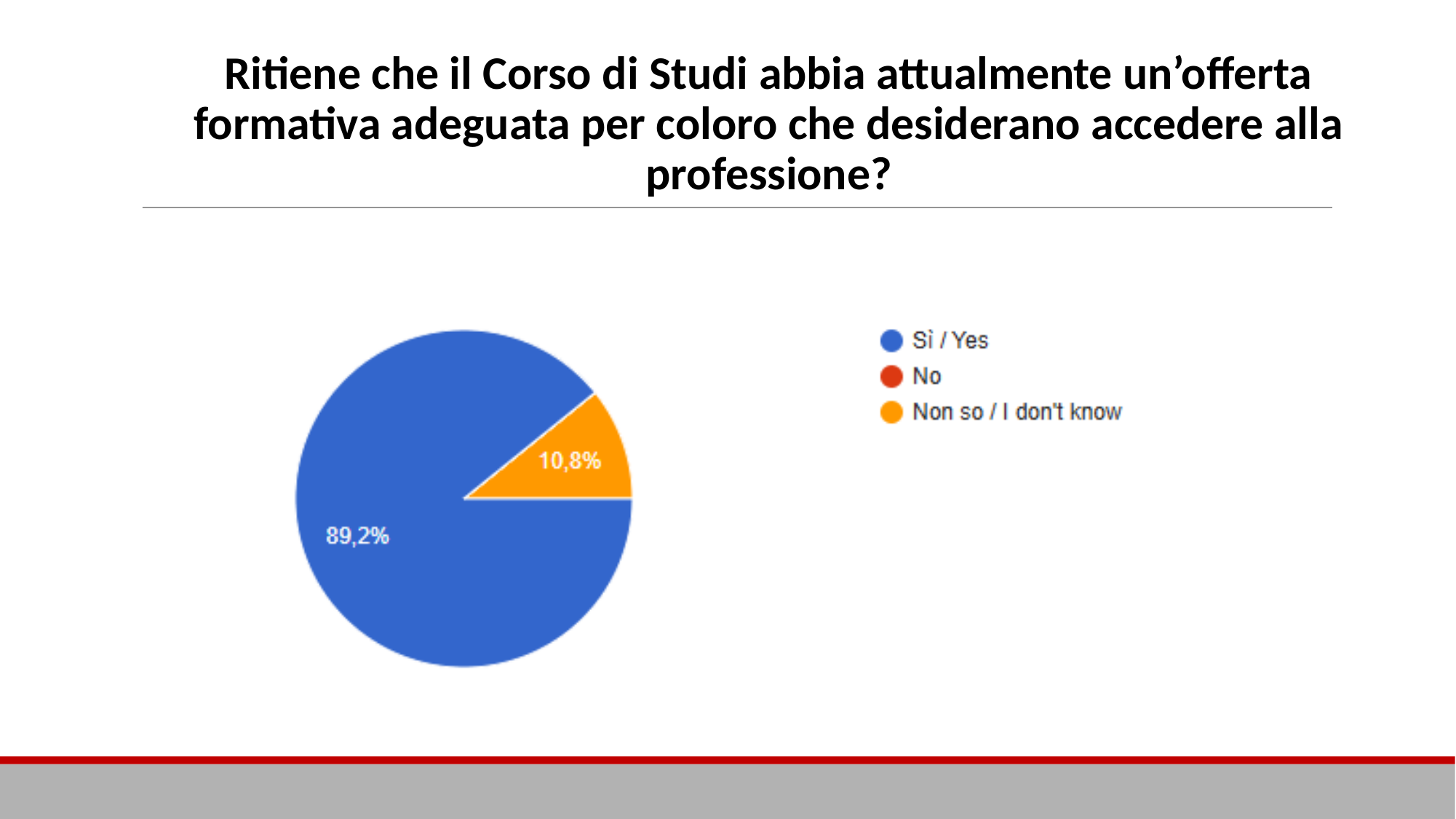
How many entries does the legend list? 3 What is the difference in percentage points between the "Sì / Yes" slice and the "Non so / I don't know" slice? 78,4 What share of the pie does the "Non so / I don't know" slice represent? 10,8% How many slices with a printed percentage label are visible in the pie? 2 Is the share for "Sì / Yes" greater or less than 50%? greater What kind of chart is shown on the slide? pie chart Which response has the largest slice of the pie? Sì / Yes What colour is the "Non so / I don't know" slice? orange What share of the pie does the "Sì / Yes" slice represent? 89,2% Which of the two labelled slices is larger, "Sì / Yes" or "Non so / I don't know"? Sì / Yes Which legend entry is shown in blue? Sì / Yes